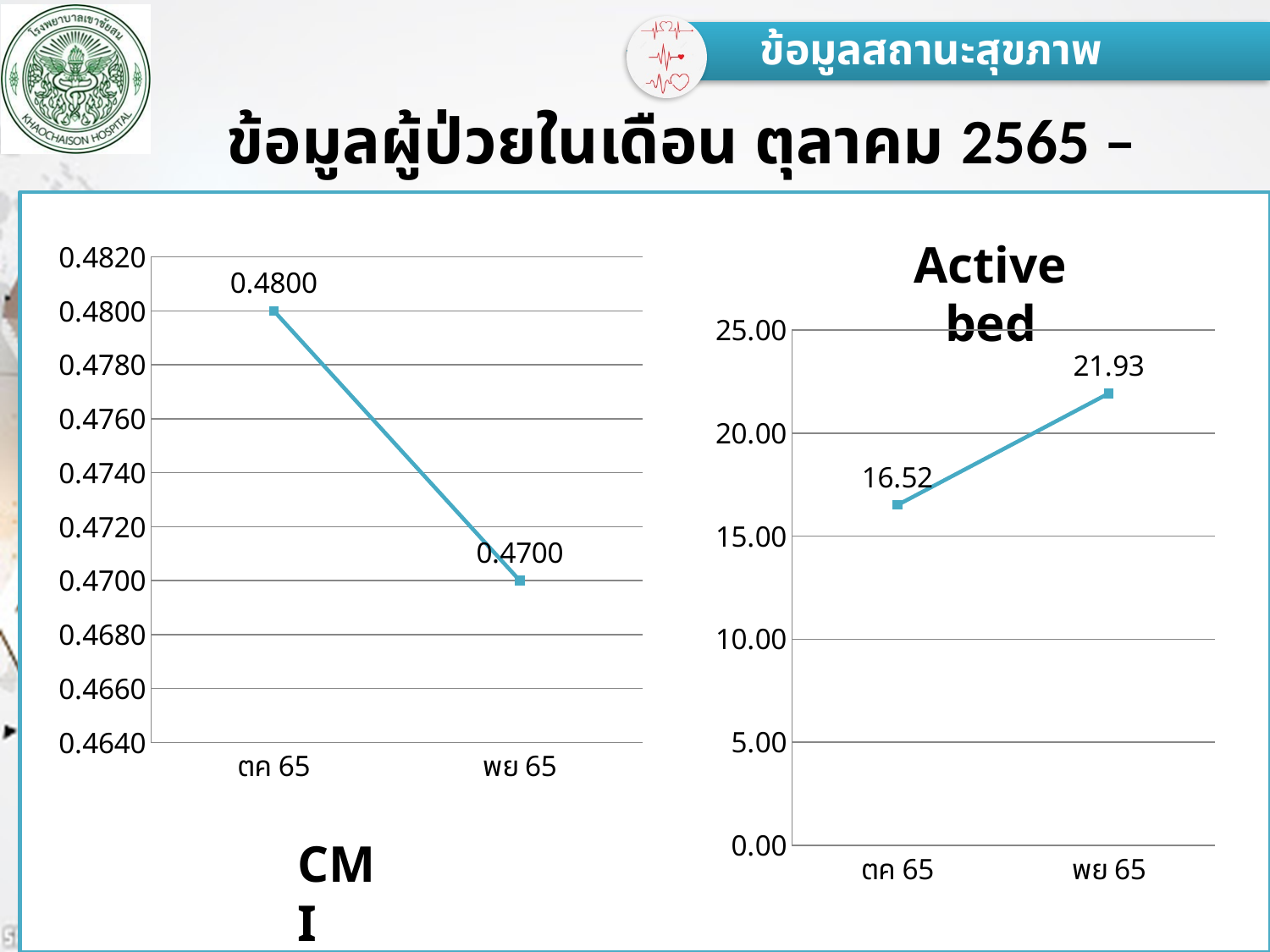
In the Active bed chart, what is the difference between the values for พย 65 and ตค 65? 5.41 In the Active bed chart, do the values rise or fall from ตค 65 to พย 65? rise In the CMI chart, what is the value for พย 65? 0.4700 In the CMI chart, what is the difference between the values for ตค 65 and พย 65? 0.0100 In the Active bed chart, what is the value for ตค 65? 16.52 What kind of chart is the Active bed chart? line chart In the CMI chart, what is the value for ตค 65? 0.4800 In the Active bed chart, which month has the higher value? พย 65 In the CMI chart, do the values rise or fall from ตค 65 to พย 65? fall In the Active bed chart, is the value for ตค 65 greater or less than 20.00? less In the Active bed chart, what is the value for พย 65? 21.93 In the CMI chart, which month has the lower value? พย 65